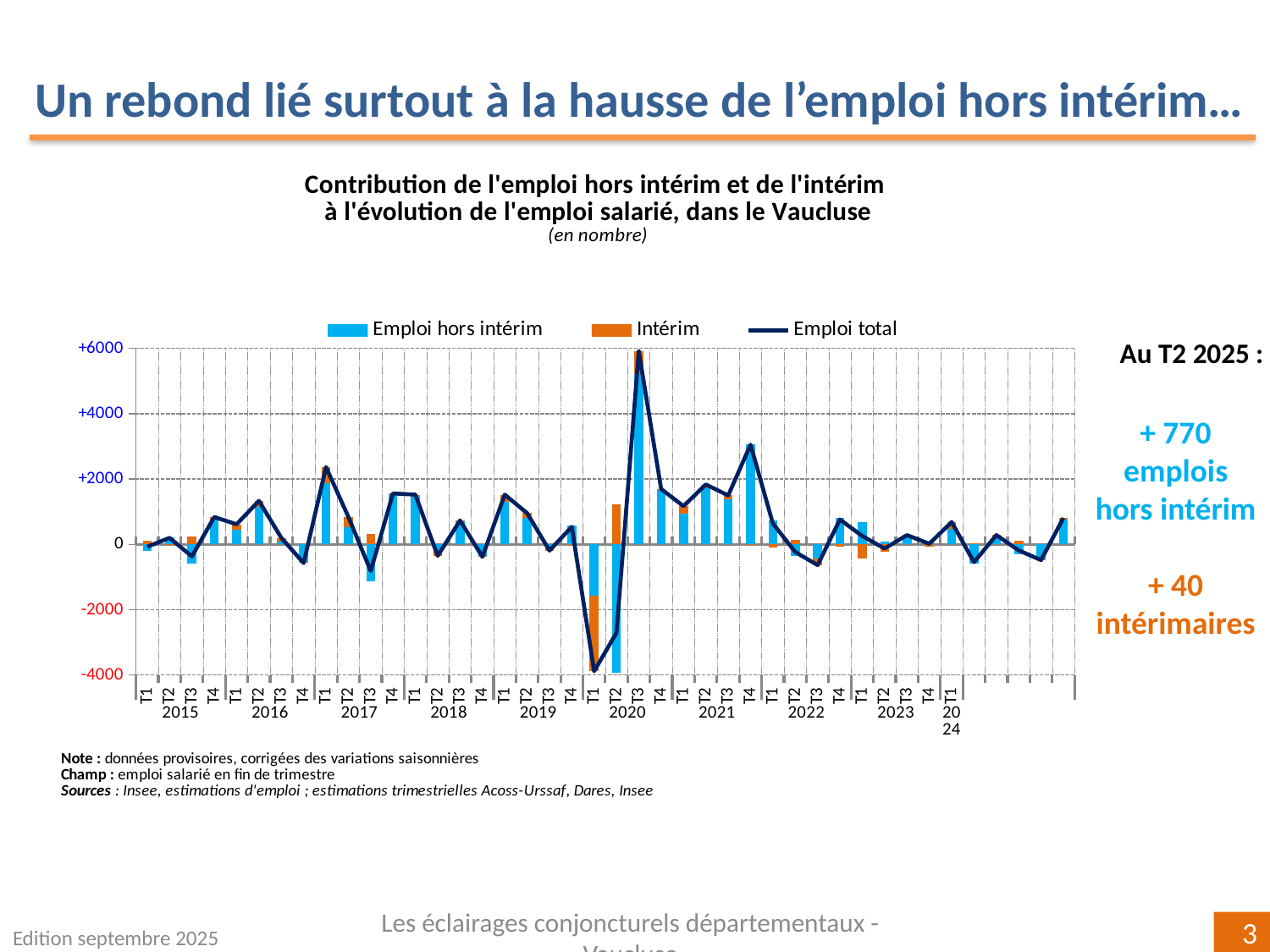
According to the slide, what is the contribution of 'intérimaires' at T2 2025? + 40 In which quarter does the 'Emploi total' line reach its highest value? T3 2020 Which colour represents the 'Intérim' series in the chart? Orange In which quarter does the 'Emploi total' line reach its lowest value? T1 2020 Is the 'Emploi total' value at T3 2020 greater or less than +4000? greater How many series does the chart legend list? 3 What kind of chart is shown on the slide? A combined bar and line chart Which is larger for 'Emploi total': the value at T3 2020 or the value at T4 2021? T3 2020 Is the 'Emploi total' value at T1 2020 greater or less than -2000? less According to the slide, what is the contribution of 'emplois hors intérim' at T2 2025? + 770 What is the title of the chart? Contribution de l'emploi hors intérim et de l'intérim à l'évolution de l'emploi salarié, dans le Vaucluse Is the 'Emploi total' value at T4 2021 greater or less than +2000? greater